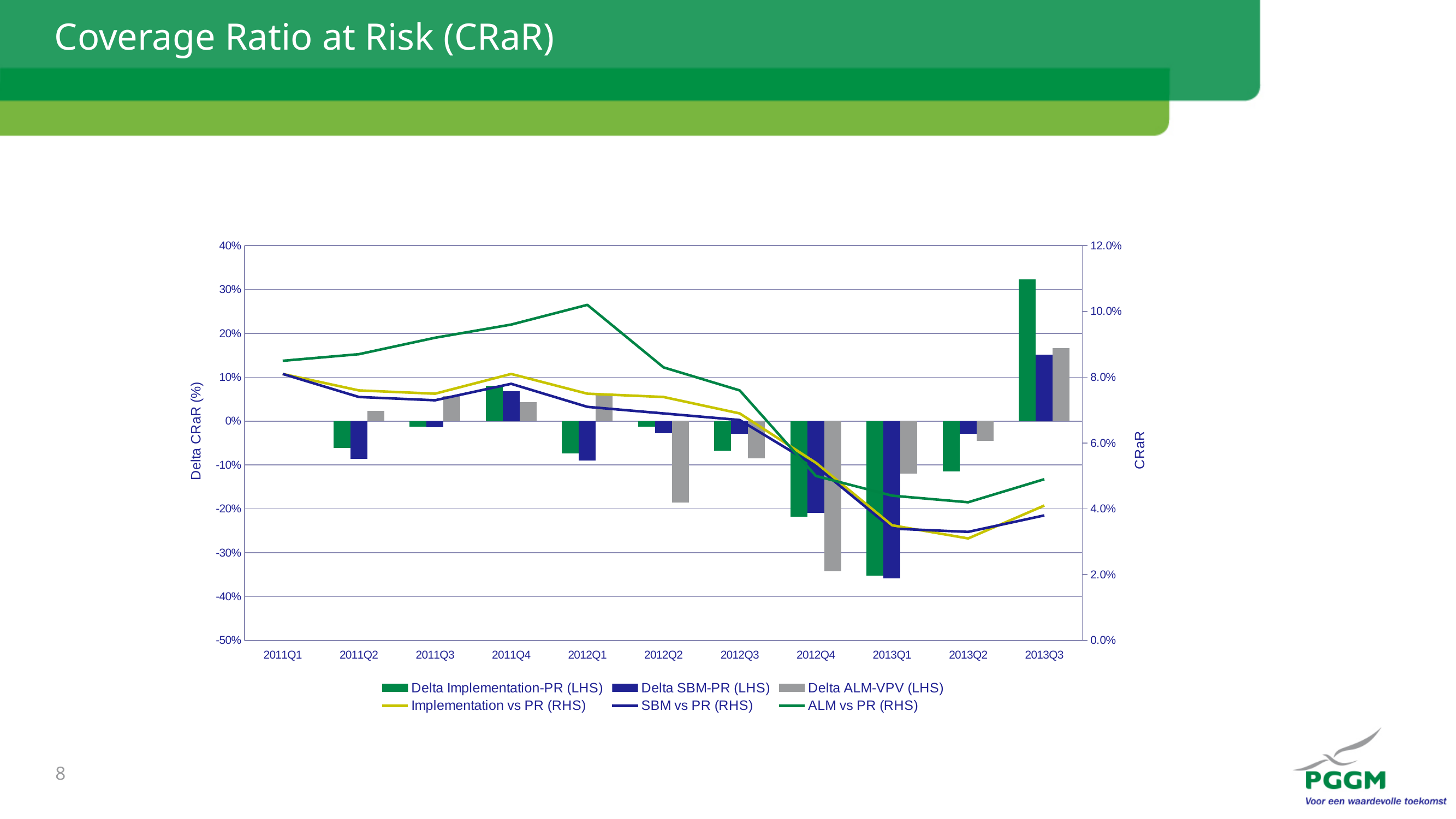
Does the ALM vs PR (RHS) line rise or fall from 2012Q1 to 2013Q1? Fall In which quarter is the Delta Implementation-PR (LHS) bar lowest? 2013Q1 How many series does the legend list? 6 In which quarter is the Delta Implementation-PR (LHS) bar highest? 2013Q3 Is the value for Implementation vs PR (RHS) in 2013Q2 greater or less than 4.0%? less In 2012Q4, which bar is lower: Delta ALM-VPV (LHS) or Delta Implementation-PR (LHS)? Delta ALM-VPV (LHS) Is the value for Delta Implementation-PR (LHS) in 2013Q3 greater or less than 30%? greater Is the value for Delta ALM-VPV (LHS) in 2012Q4 greater or less than -30%? less What kind of chart is shown on the slide? Combined bar and line chart How many quarters are shown on the x axis? 11 In which quarter is the Delta ALM-VPV (LHS) bar lowest? 2012Q4